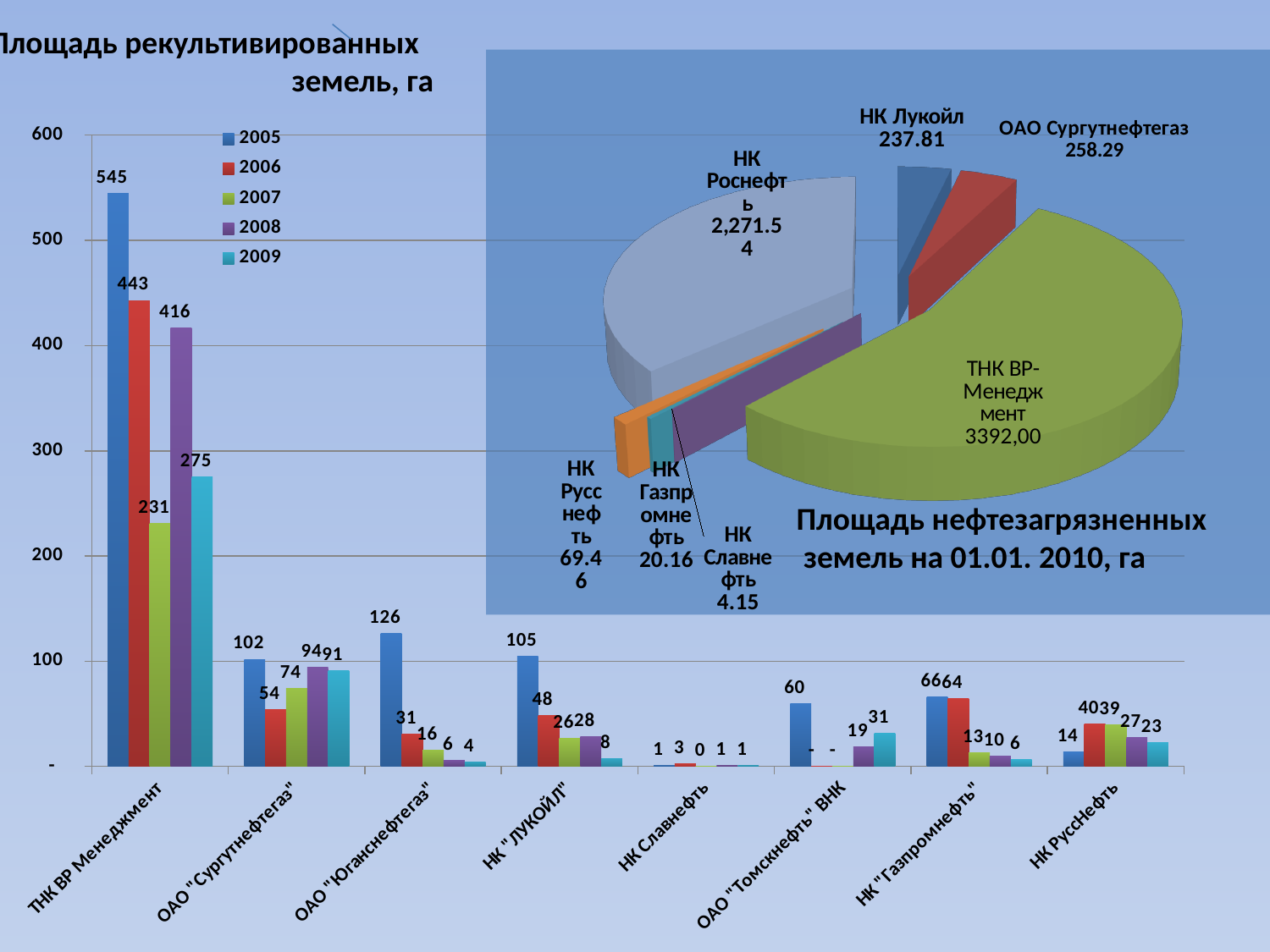
In the pie chart 'Площадь нефтезагрязненных земель на 01.01. 2010, га', which company has the largest slice? ТНК ВР-Менеджмент In the bar chart 'Площадь рекультивированных земель, га', what is the value for ОАО "Сургутнефтегаз" in 2007? 74 In the bar chart 'Площадь рекультивированных земель, га', how many series does the legend list? 5 In the pie chart 'Площадь нефтезагрязненных земель на 01.01. 2010, га', what is the value for НК Лукойл? 237.81 What kind of chart is the one on the right of the slide, 'Площадь нефтезагрязненных земель на 01.01. 2010, га'? pie chart In the bar chart 'Площадь рекультивированных земель, га', what is the value for НК "ЛУКОЙЛ" in 2006? 48 In the bar chart 'Площадь рекультивированных земель, га', what is the value for ТНК ВР Менеджмент in 2005? 545 In the bar chart 'Площадь рекультивированных земель, га', what is the difference between the 2005 and 2006 values for ТНК ВР Менеджмент? 102 In the bar chart 'Площадь рекультивированных земель, га', how many categories are shown on the x axis? 8 In the bar chart 'Площадь рекультивированных земель, га', which is larger for ОАО "Юганскнефтегаз": the 2005 value or the 2006 value? 2005 In the bar chart 'Площадь рекультивированных земель, га', do the values for ОАО "Юганскнефтегаз" rise or fall from 2005 to 2009? fall In the bar chart 'Площадь рекультивированных земель, га', which category has the highest 2005 value? ТНК ВР Менеджмент